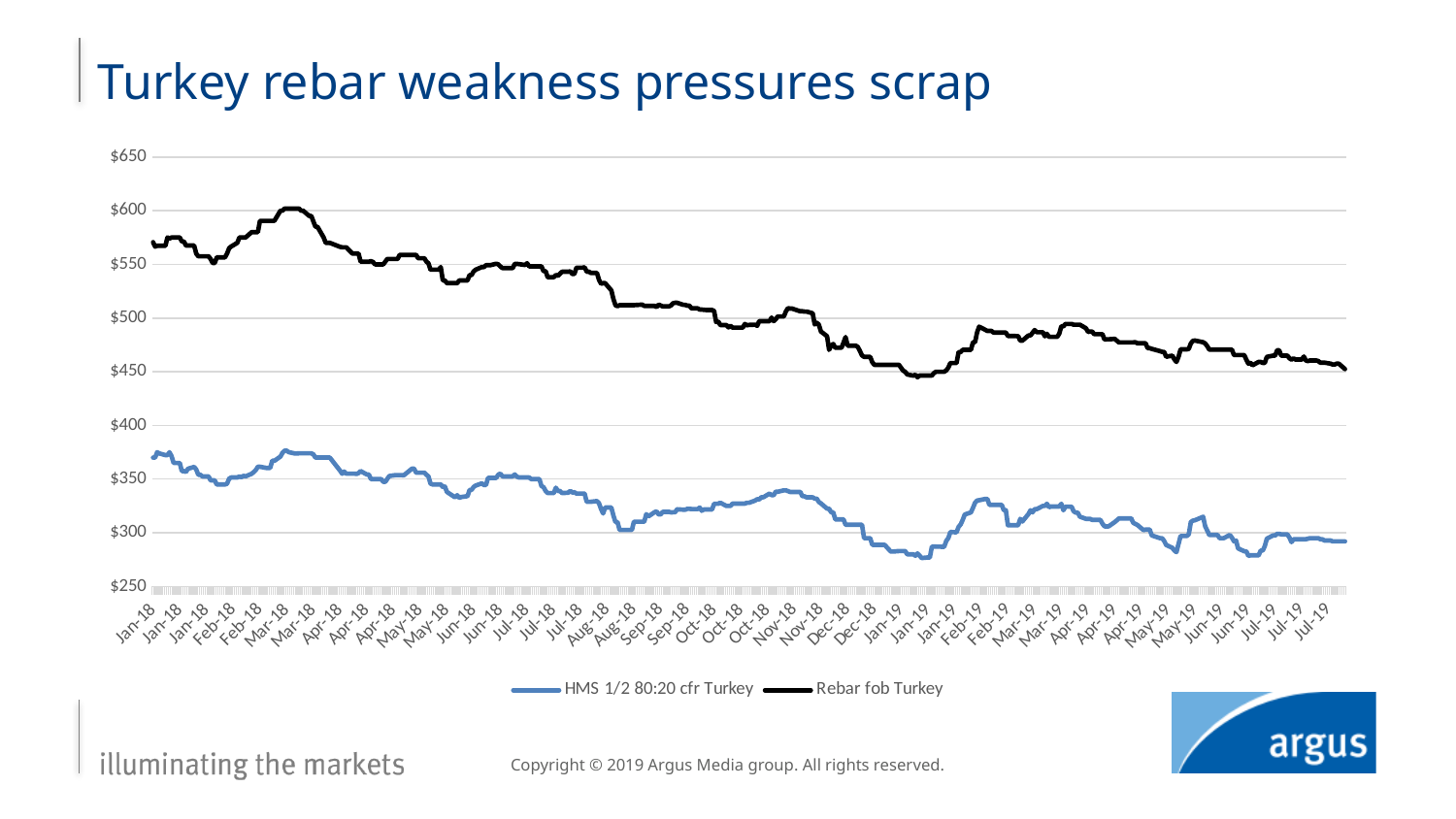
Is the value for Rebar fob Turkey at the end of the chart (Jul-19) greater or less than $500? less Is the value for HMS 1/2 80:20 cfr Turkey at the start of the chart (Jan-18) greater or less than $350? greater Overall, do the Rebar fob Turkey values rise or fall from Jan-18 to Jul-19? fall Overall, do the HMS 1/2 80:20 cfr Turkey values rise or fall from Jan-18 to Jul-19? fall Is the value for HMS 1/2 80:20 cfr Turkey at the end of the chart (Jul-19) greater or less than $300? less What kind of chart is shown on the slide? line chart What is the title of the chart on the slide? Turkey rebar weakness pressures scrap How many series does the legend list? 2 Which series has the higher values throughout the chart, HMS 1/2 80:20 cfr Turkey or Rebar fob Turkey? Rebar fob Turkey Which series is drawn in black? Rebar fob Turkey What is the highest value shown on the y axis? $650